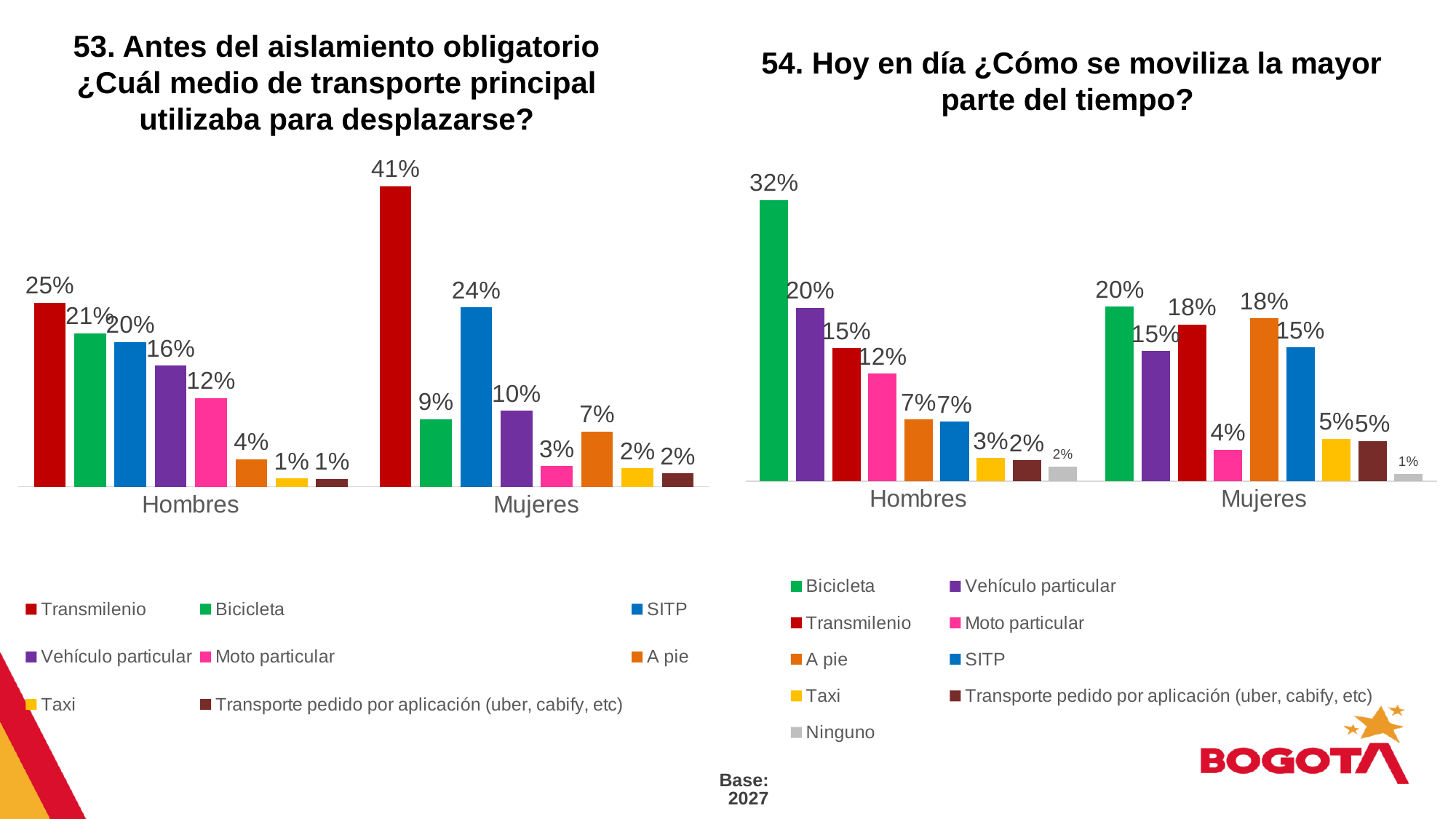
In the right chart (question 54), what is the difference between the Bicicleta values for Hombres and Mujeres? 12% In the right chart (question 54), what percentage of Hombres move mainly by Bicicleta? 32% In the right chart (question 54), which means of transport has the lowest value for Mujeres? Ninguno In the left chart (question 53), what percentage of Mujeres used Transmilenio as their main means of transport? 41% In the right chart (question 54), which is larger for Hombres: Vehículo particular or Transmilenio? Vehículo particular In the right chart (question 54), what percentage of Mujeres move mainly by A pie? 18% In the right chart (question 54), how many series does the legend list? 9 In the left chart (question 53), how many series does the legend list? 8 In the left chart (question 53), what is the difference between the Transmilenio values for Mujeres and Hombres? 16% What type of chart is used for question 54 on the right? Bar chart In the left chart (question 53), what percentage of Hombres used Bicicleta? 21% In the left chart (question 53), which means of transport has the highest value for Hombres? Transmilenio